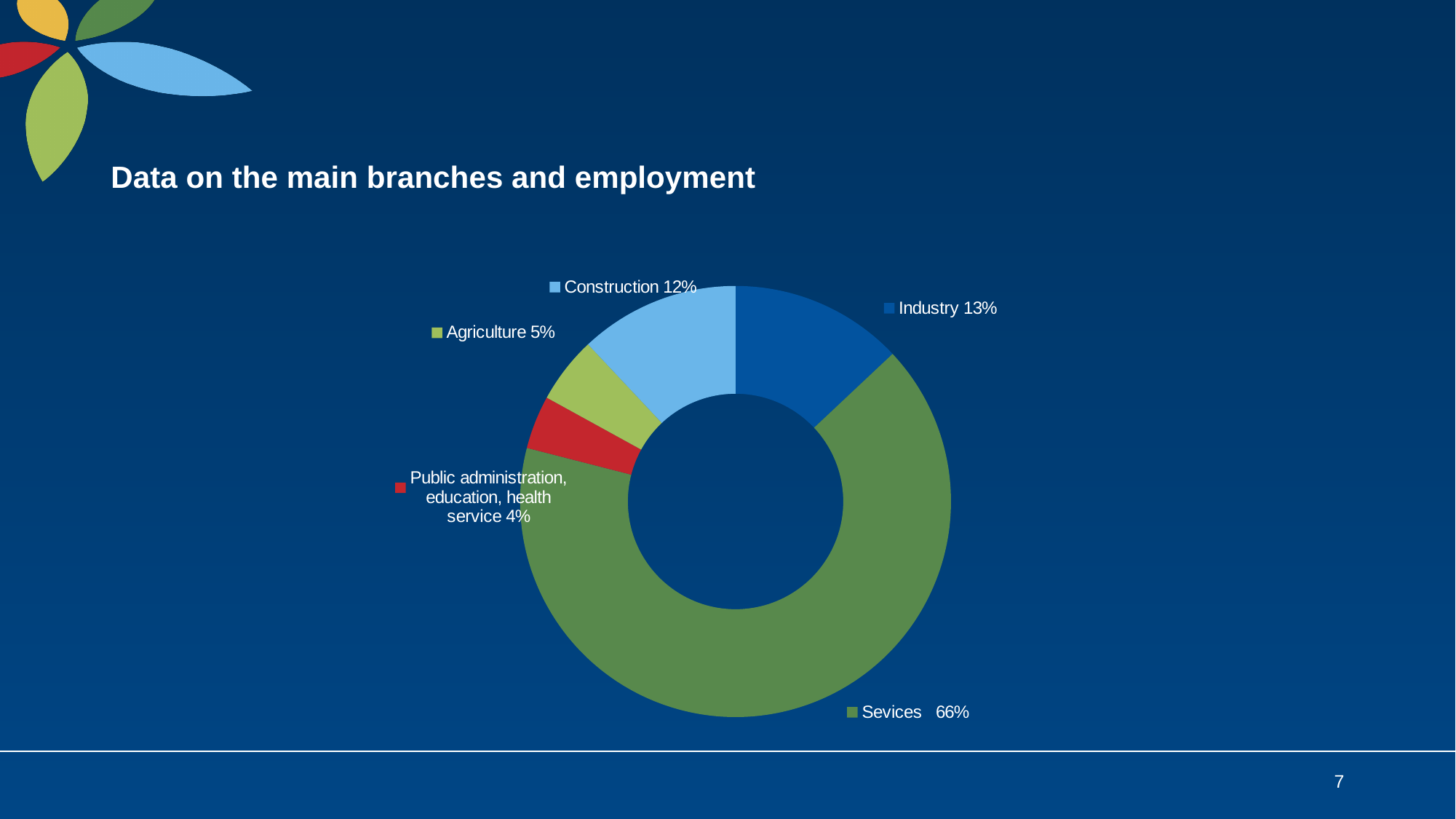
What share of employment does Agriculture account for? 5% What share of employment does Sevices account for? 66% Which has a larger share, Agriculture or Construction? Construction Which branch has the largest share of employment? Sevices What share of employment does Public administration, education, health service account for? 4% What is the difference in percentage points between the Sevices share and the Industry share? 53 Which branch has the smallest share of employment? Public administration, education, health service What is the title of the slide? Data on the main branches and employment What share of employment does Construction account for? 12% How many branches are shown in the chart? 5 What share of employment does Industry account for? 13% What kind of chart is shown on the slide? Pie chart (doughnut)